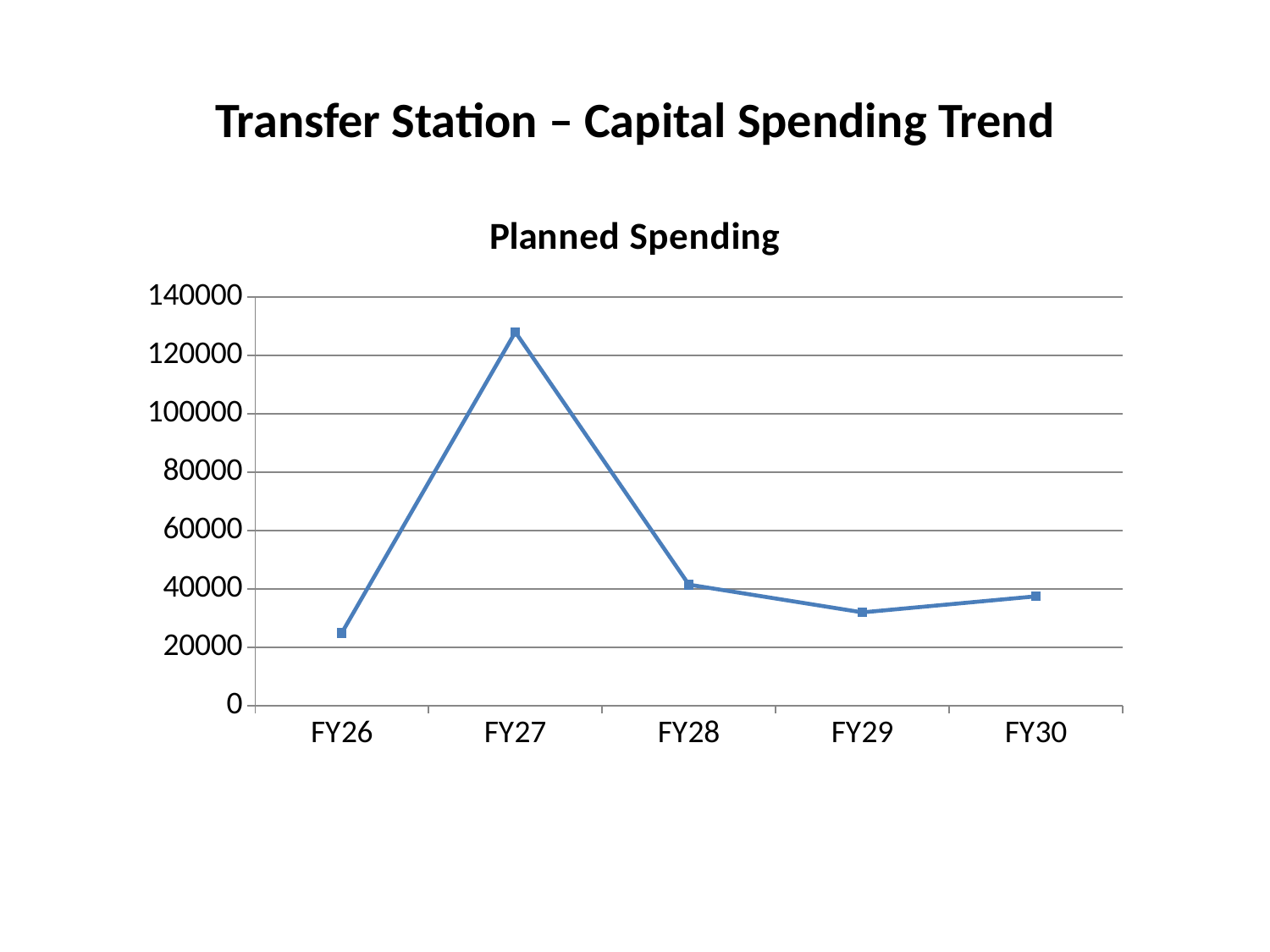
Is the value for FY28 greater or less than 60000? less Is the value for FY27 greater or less than 120000? greater Which has the larger planned spending, FY26 or FY29? FY29 Is the value for FY29 greater or less than 20000? greater Which has the larger planned spending, FY28 or FY29? FY28 What kind of chart is shown on the slide? line chart Which fiscal year has the lowest planned spending? FY26 Does planned spending rise or fall from FY27 to FY28? fall What is the title of the chart? Planned Spending Which fiscal year has the highest planned spending? FY27 How many fiscal years are plotted on the x axis? 5